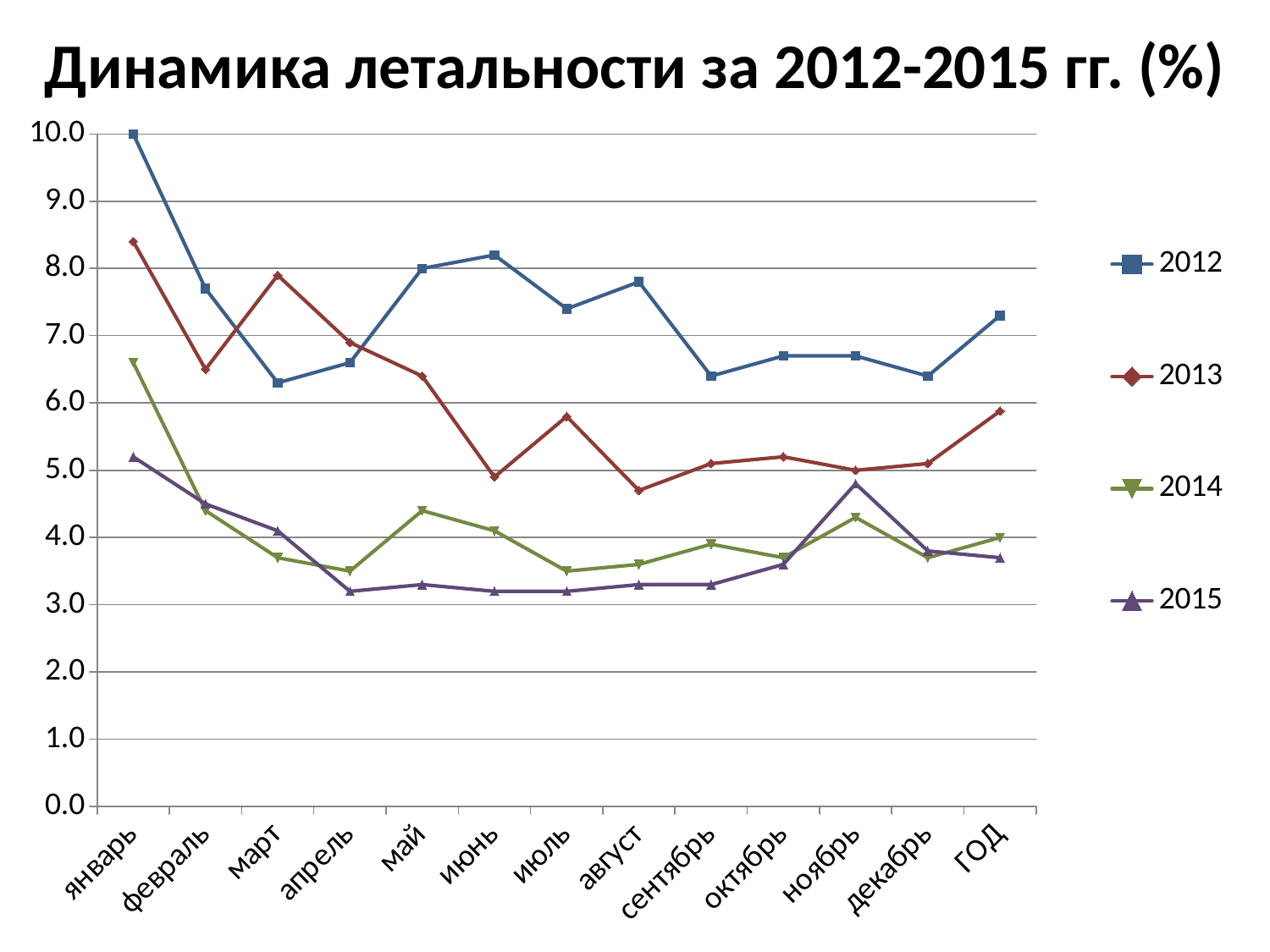
How many categories are shown along the x axis? 13 What is the value for 2012 in январь? 10.0 What kind of chart is shown on the slide? line chart How many series does the legend list? 4 What is the title of the chart? Динамика летальности за 2012-2015 гг. (%) Is the value for 2015 in апрель greater or less than 4.0? less Is the value for 2012 in март greater or less than 7.0? less Which series has the lowest value in январь? 2015 Does the 2012 series rise or fall from январь to март? fall Which series has the highest value in январь? 2012 Is the value for 2013 in январь greater or less than 8.0? greater Which is larger in март, the value for 2012 or the value for 2013? 2013